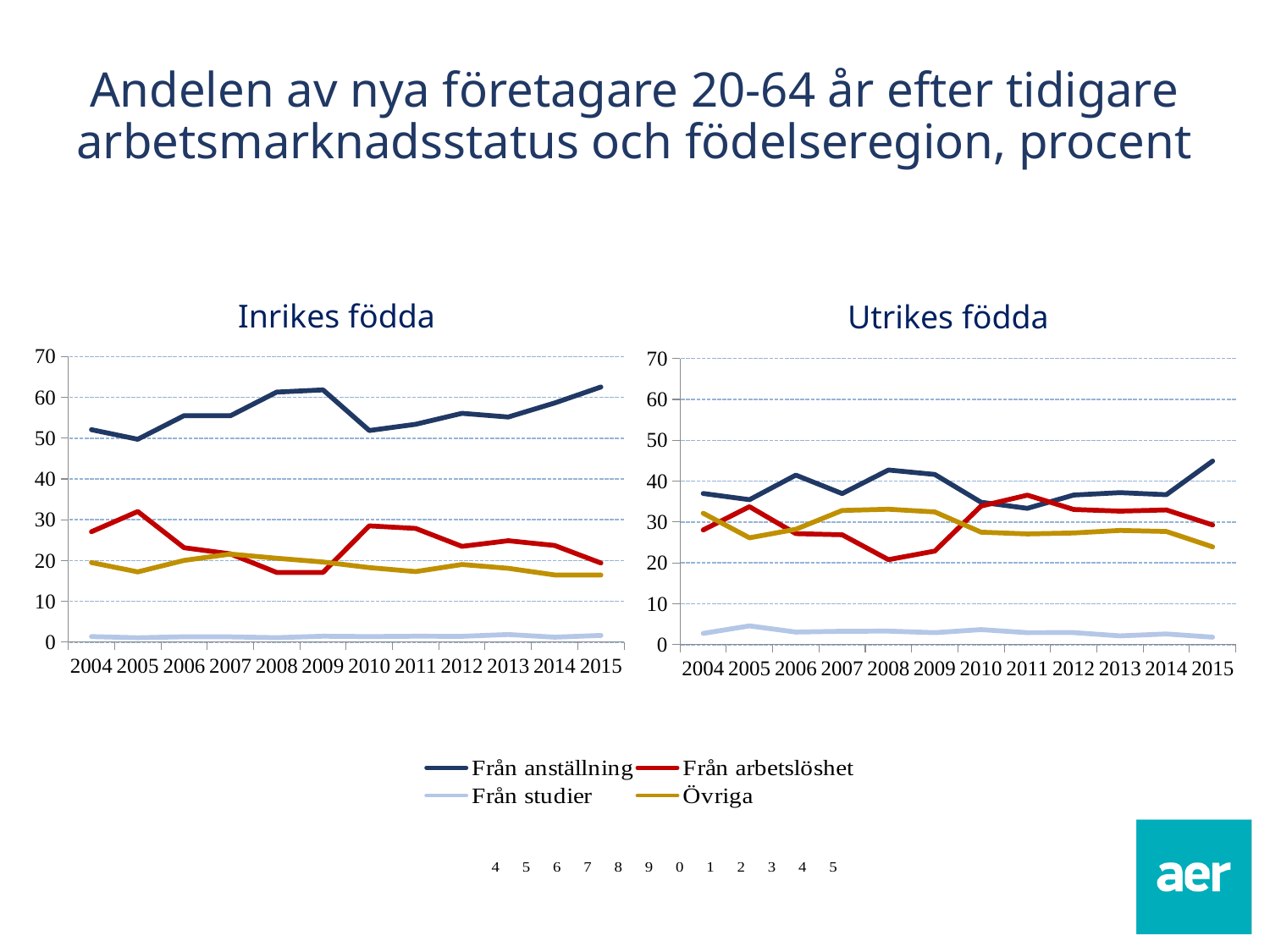
In the "Inrikes födda" chart, which series has the lowest values across all years? Från studier In the "Inrikes födda" chart, in which year is Från arbetslöshet at its highest? 2005 In the "Utrikes födda" chart, in which year is Från arbetslöshet at its lowest? 2008 How many years are plotted on the x axis of the "Utrikes födda" chart? 12 In the "Utrikes födda" chart, is the value for Från arbetslöshet in 2008 greater or less than 30? less In the "Inrikes födda" chart, is the value for Från studier in 2010 greater or less than 10? less What kind of chart is the "Inrikes födda" chart? Line chart In the "Inrikes födda" chart, is the value for Från anställning in 2015 greater or less than 60? greater How many series does the legend list? 4 What is the title of the chart on the right? Utrikes födda In the "Inrikes födda" chart, does Från anställning rise or fall from 2010 to 2015? Rise In the "Utrikes födda" chart, which is larger in 2008: Övriga or Från arbetslöshet? Övriga